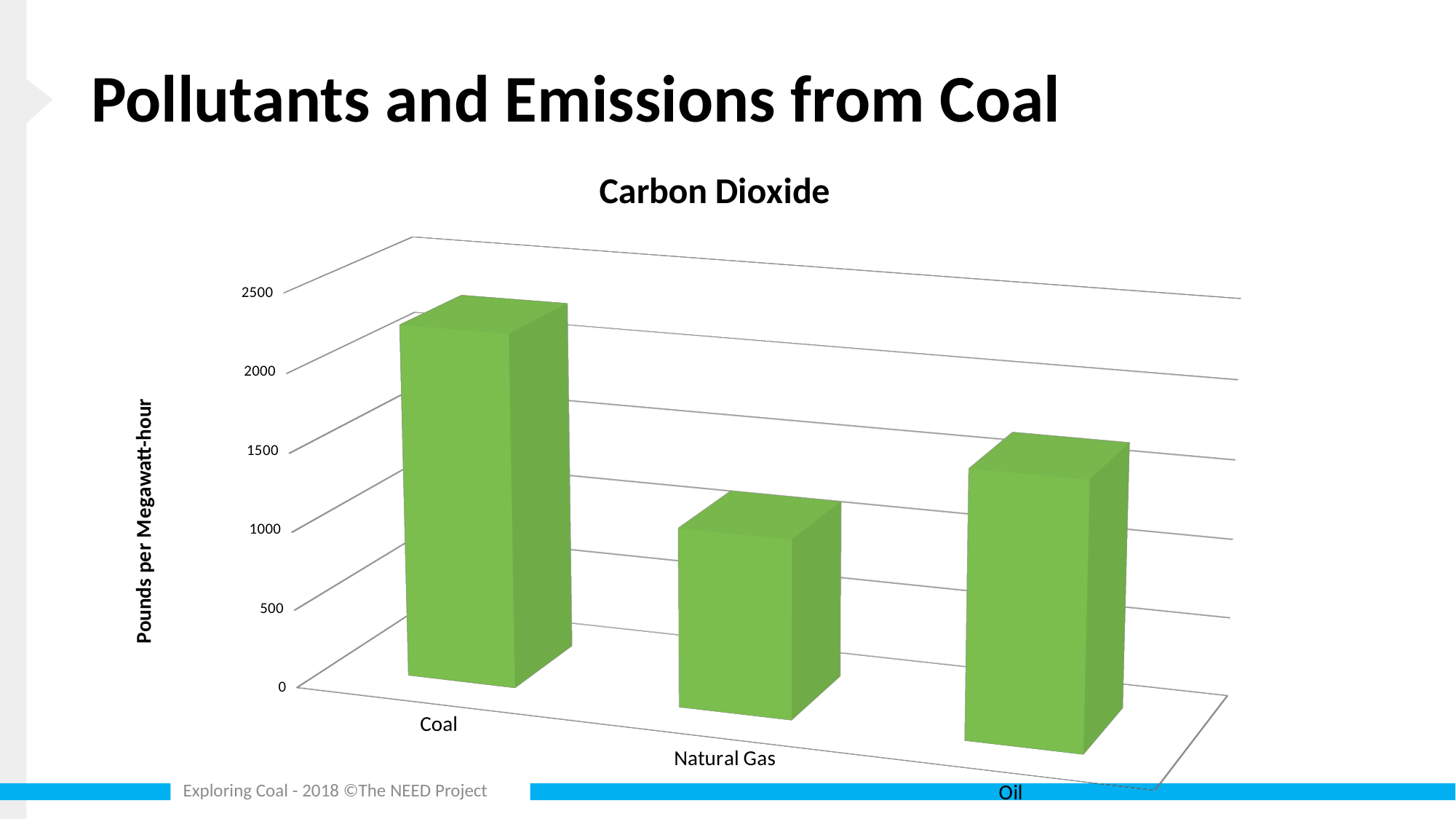
Which category has the highest carbon dioxide value? Coal Which category has the lowest carbon dioxide value? Natural Gas What is the label on the vertical axis of the chart? Pounds per Megawatt-hour Is the value for Oil greater or less than 2000? less Is the value for Oil greater or less than 1000? greater Is the value for Coal greater or less than 2000? greater What is the title of the chart? Carbon Dioxide Which has a larger value, Coal or Oil? Coal Which has a larger value, Oil or Natural Gas? Oil What kind of chart is shown on the slide? bar chart How many categories are shown on the x axis of the chart? 3